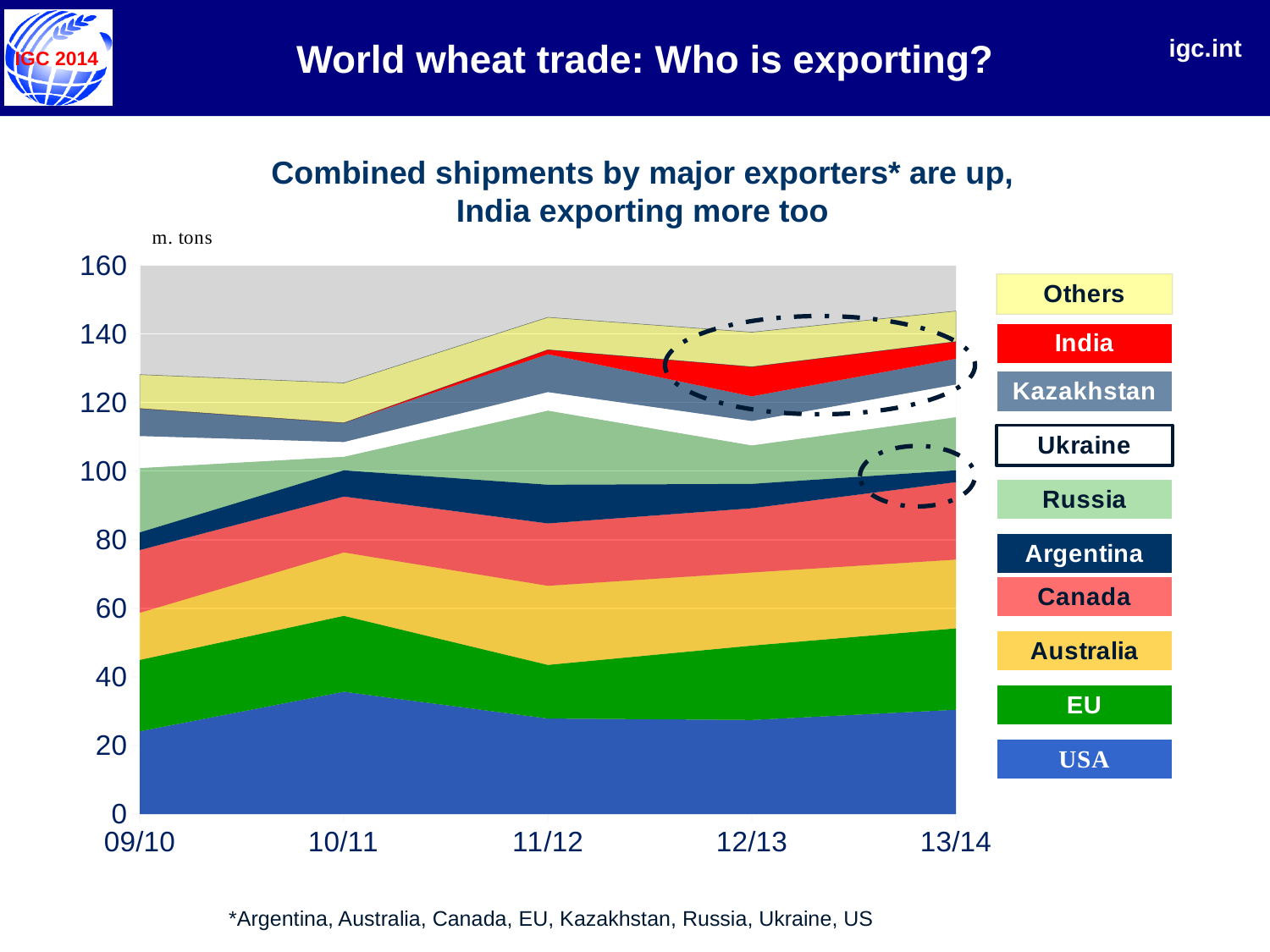
What unit is shown on the y axis? m. tons Is the combined total of all exporters in 13/14 greater or less than 140? greater Is the combined total of all exporters in 10/11 greater or less than 140? less Is the value for USA in 13/14 greater or less than 40? less How many seasons are plotted along the x axis? 5 Is the value for USA larger in 09/10 or in 10/11? 10/11 Which series is at the bottom of the stack? USA What kind of chart is shown on the slide? stacked area chart How many series does the legend list? 10 Does the value for USA rise or fall from 09/10 to 10/11? rise